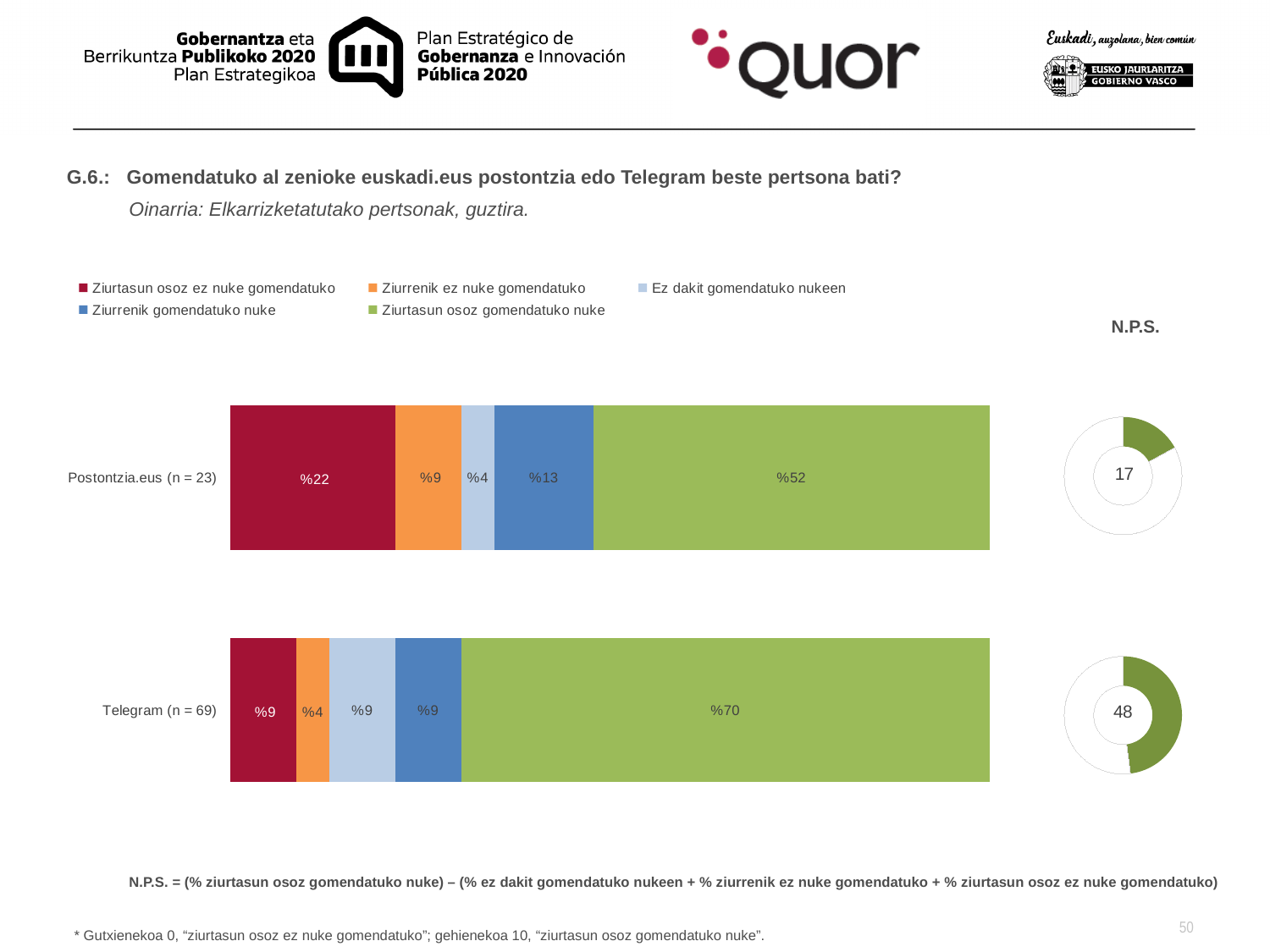
What type of chart is used to show the response distribution for Postontzia.eus and Telegram? Stacked bar chart Which of the two services has the higher N.P.S. value? Telegram In the stacked bar chart, what percentage of Telegram respondents answered "Ziurtasun osoz gomendatuko nuke"? %70 In the stacked bar chart, what percentage of Postontzia.eus respondents answered "Ziurtasun osoz gomendatuko nuke"? %52 In the stacked bar chart, what percentage of Telegram respondents answered "Ez dakit gomendatuko nukeen"? %9 What is the N.P.S. value shown in the donut chart for Postontzia.eus? 17 In the stacked bar chart, what percentage of Postontzia.eus respondents answered "Ziurtasun osoz ez nuke gomendatuko"? %22 In the stacked bar chart, which service has the larger share of "Ziurtasun osoz ez nuke gomendatuko" responses? Postontzia.eus What is the N.P.S. value shown in the donut chart for Telegram? 48 In the stacked bar chart, what is the difference in percentage points between the "Ziurtasun osoz gomendatuko nuke" share for Telegram and for Postontzia.eus? 18 percentage points What is the difference between the N.P.S. values of Telegram and Postontzia.eus? 31 How many series does the legend of the stacked bar chart list? 5